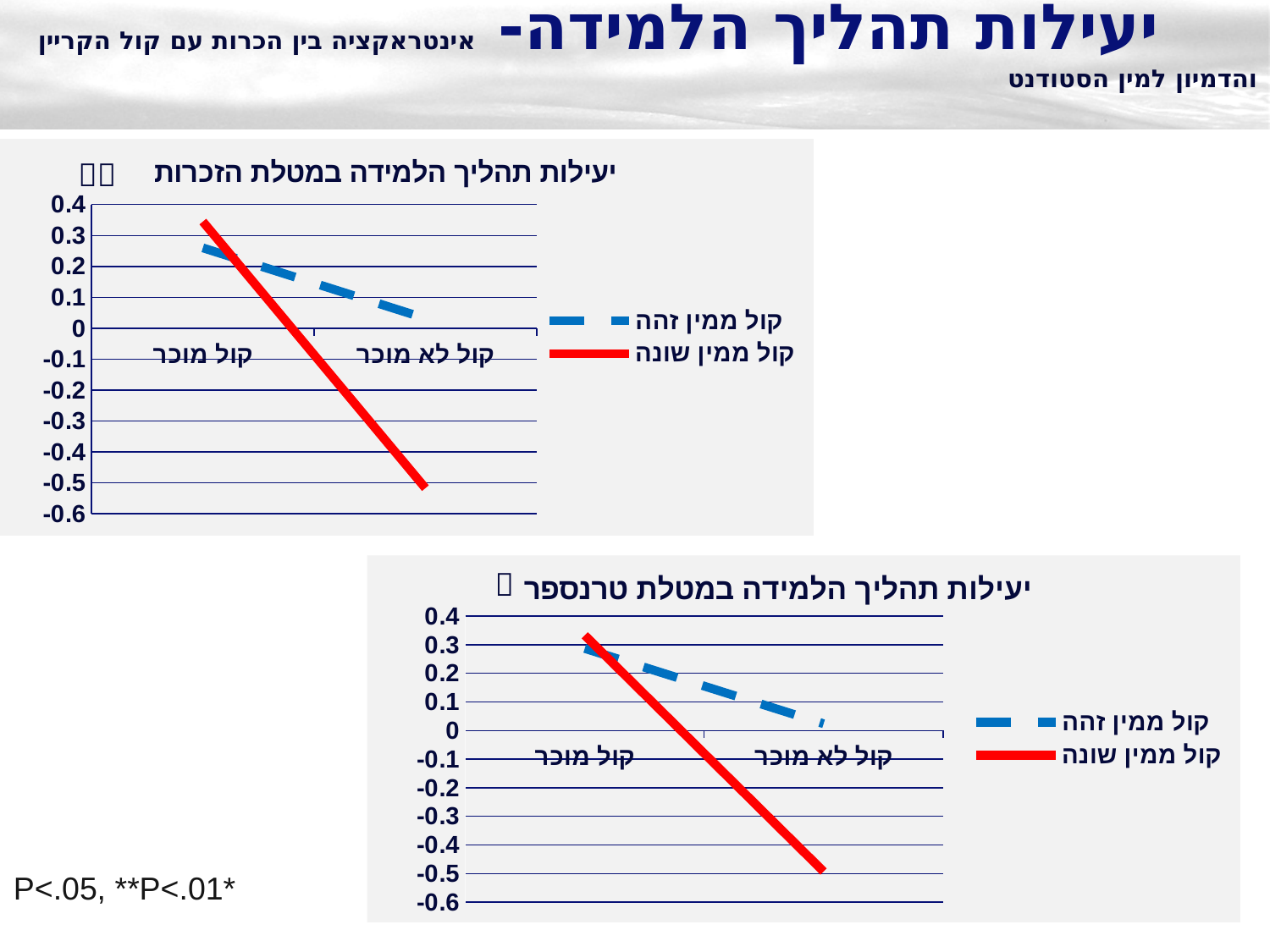
In the top chart, 'יעילות תהליך הלמידה במטלת הזכרות', which series has the higher value at 'קול לא מוכר'? קול ממין זהה In the top chart, 'יעילות תהליך הלמידה במטלת הזכרות', what colour is the line for 'קול ממין שונה'? red How many series does the legend of the bottom chart, 'יעילות תהליך הלמידה במטלת טרנספר', list? 2 What kind of chart is the top chart, 'יעילות תהליך הלמידה במטלת הזכרות'? line chart In the bottom chart, 'יעילות תהליך הלמידה במטלת טרנספר', which series has the higher value at 'קול לא מוכר'? קול ממין זהה How many categories are shown on the x axis of the top chart, 'יעילות תהליך הלמידה במטלת הזכרות'? 2 In the top chart, 'יעילות תהליך הלמידה במטלת הזכרות', is the value of 'קול ממין זהה' at 'קול לא מוכר' greater or less than 0.1? less In the top chart, 'יעילות תהליך הלמידה במטלת הזכרות', is the value of 'קול ממין שונה' at 'קול מוכר' greater or less than 0.2? greater In the bottom chart, 'יעילות תהליך הלמידה במטלת טרנספר', does the 'קול ממין שונה' series rise or fall from 'קול מוכר' to 'קול לא מוכר'? fall In the bottom chart, 'יעילות תהליך הלמידה במטלת טרנספר', is the value of 'קול ממין שונה' at 'קול לא מוכר' greater or less than -0.3? less